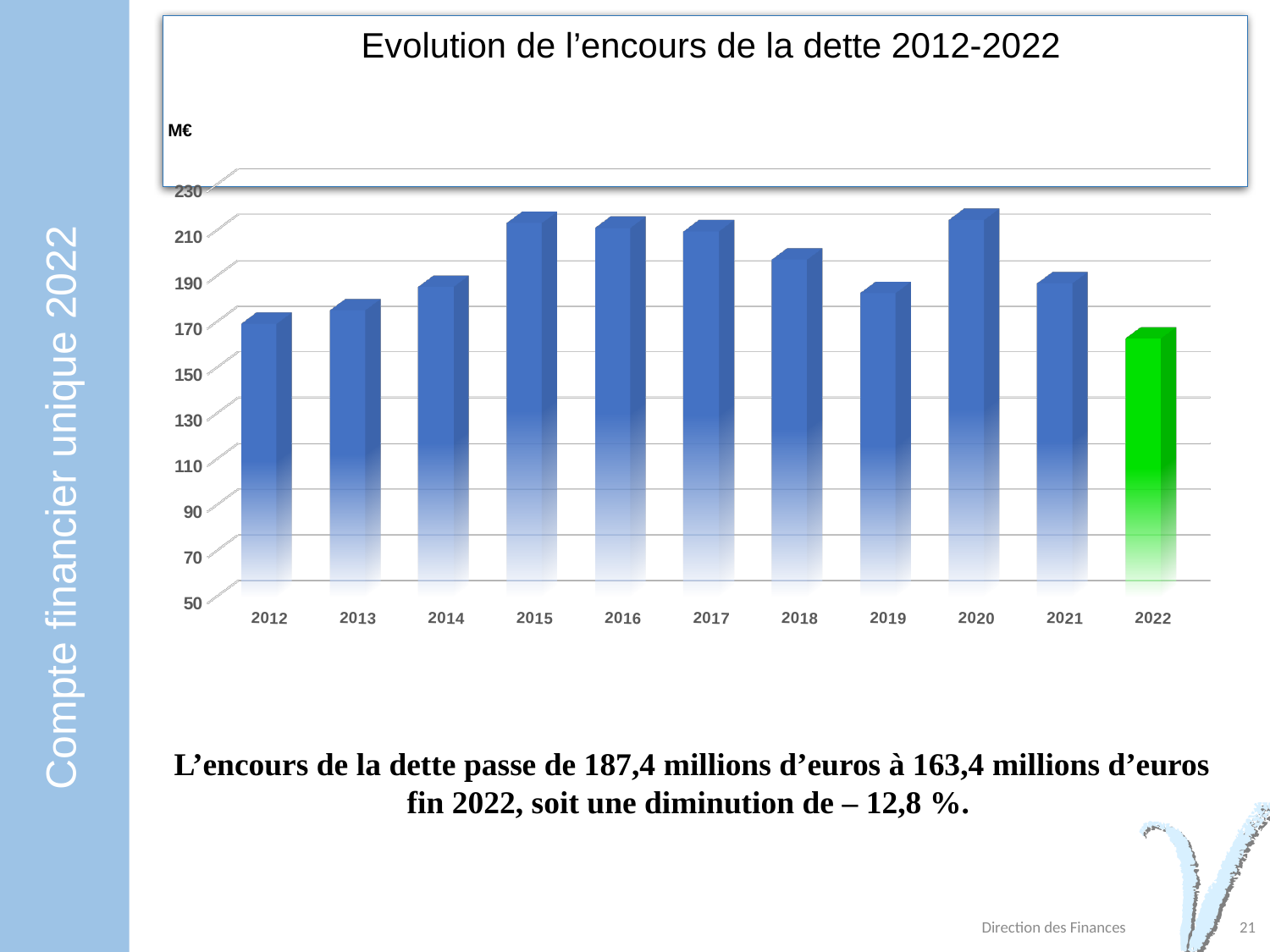
What is the debt outstanding at the end of 2022, as stated on the slide? 163,4 millions d’euros Is the value for 2019 greater or less than 190? less Which year has the lowest debt outstanding in the chart? 2022 Which year has the larger value, 2018 or 2019? 2018 What is the title of the chart? Evolution de l’encours de la dette 2012-2022 How many years are plotted on the x axis of the chart? 11 What is the debt outstanding for 2021, as stated on the slide? 187,4 millions d’euros Which year's bar is shown in green rather than blue? 2022 What kind of chart is shown on the slide? bar chart Is the value for 2012 greater or less than 190? less Is the value for 2015 greater or less than 210? greater By what percentage did the debt outstanding decrease between 2021 and 2022, according to the slide? – 12,8 %